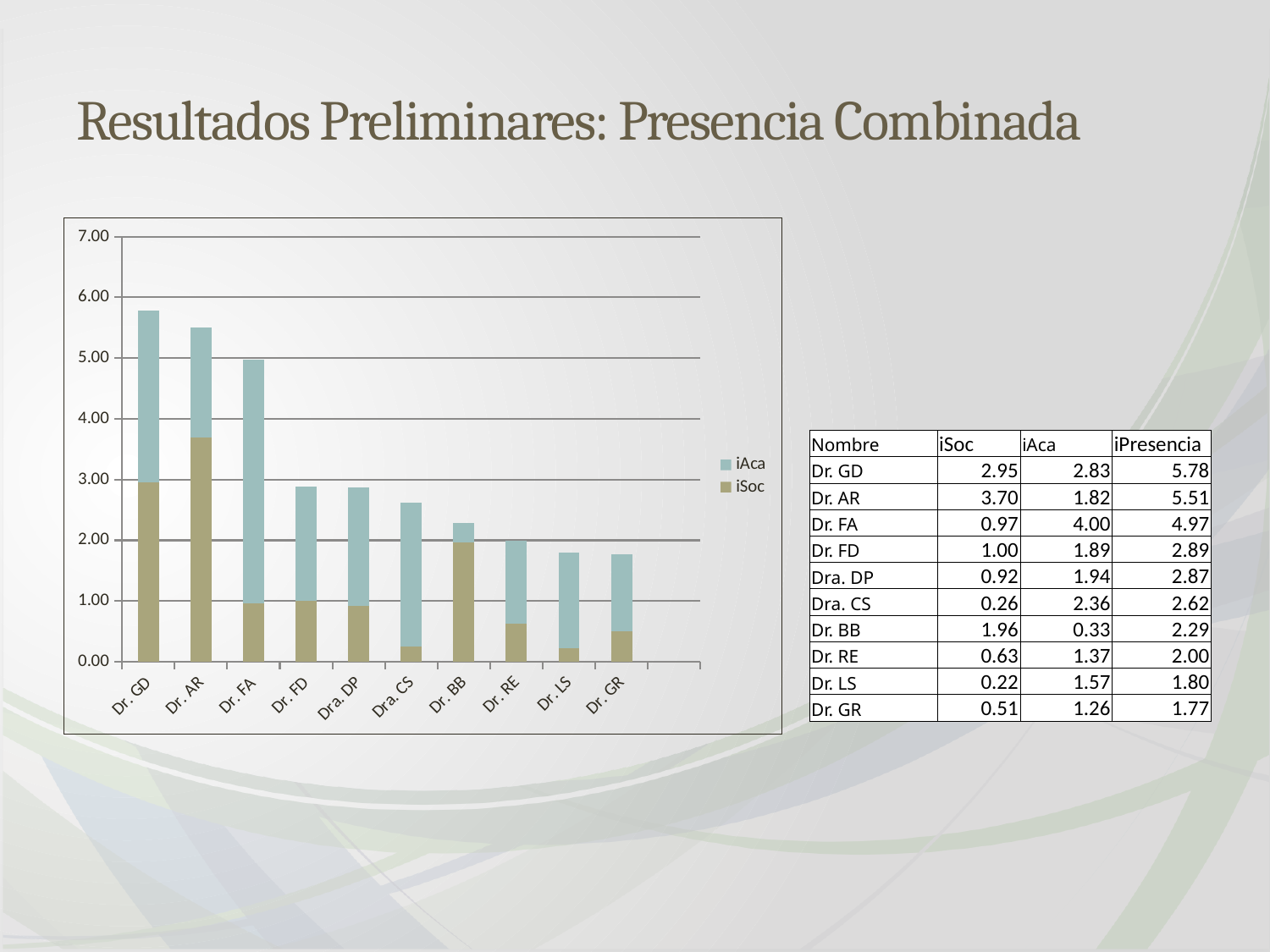
What kind of chart is shown on the slide? stacked bar chart How many series does the chart legend list? 2 Which category has the tallest stacked bar in the chart? Dr. GD What is the iAca value for Dr. FA? 4.00 Is the total stacked bar for Dr. FA greater or less than 4.00? greater Which category has the shortest stacked bar in the chart? Dr. GR Do the stacked bar totals rise or fall from left to right along the x axis? fall Which is larger, the iSoc value for Dr. BB or the iSoc value for Dr. RE? Dr. BB What is the total (iPresencia) of the stacked bar for Dr. GD? 5.78 What is the difference between the iPresencia totals of Dr. GD and Dr. AR? 0.27 How many categories (names) are shown on the x axis of the chart? 10 What is the iSoc value for Dr. AR? 3.70